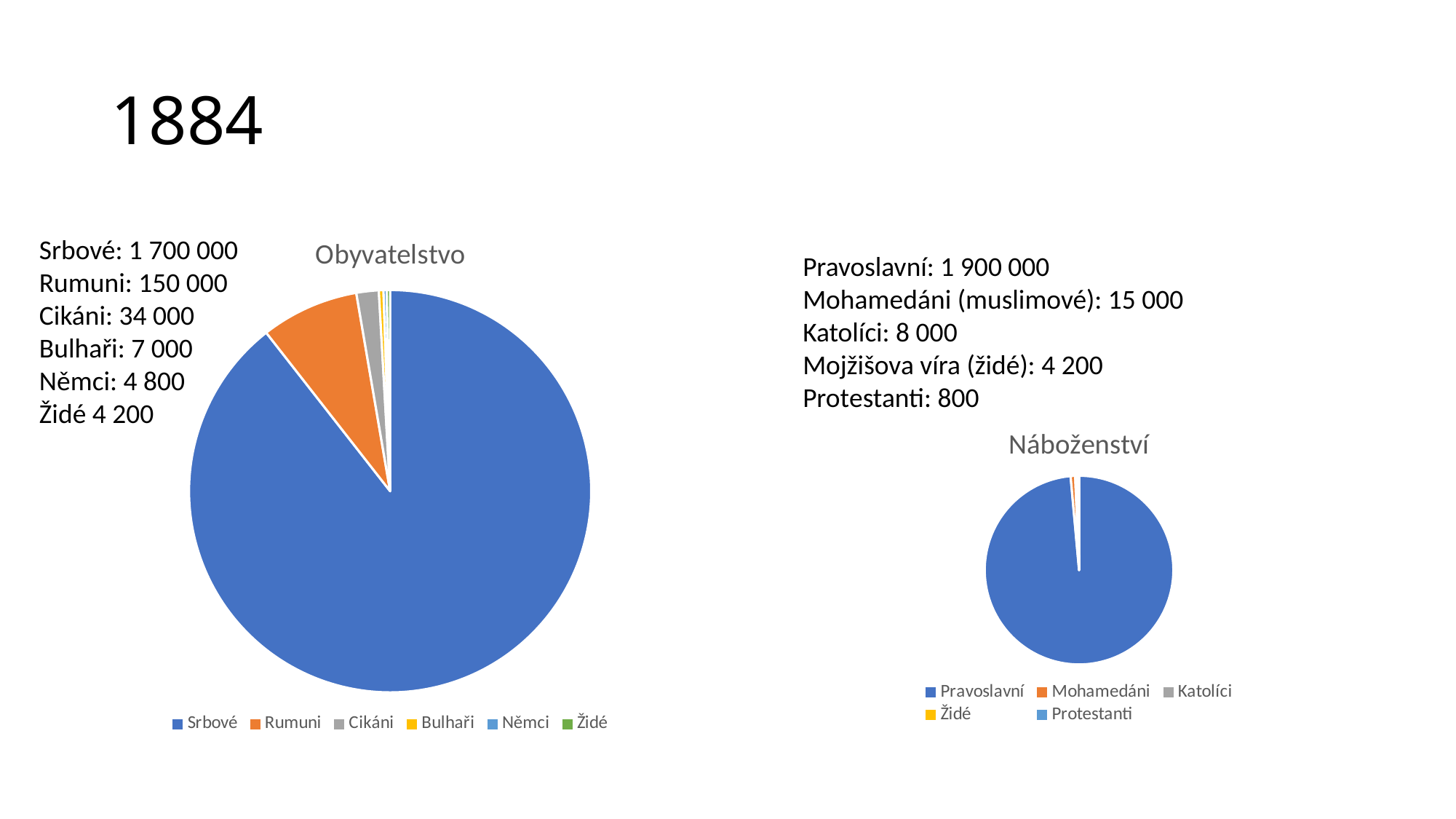
In the Obyvatelstvo chart, what is the value for Rumuni? 150 000 In the Náboženství chart, what is the value for Katolíci? 8 000 What is the title of the pie chart on the left of the slide? Obyvatelstvo How many categories does the legend of the Obyvatelstvo chart list? 6 In the Obyvatelstvo chart, which is larger, Rumuni or Cikáni? Rumuni In the Obyvatelstvo chart, what is the difference between the values for Srbové and Rumuni? 1 550 000 In the Náboženství chart, which category has the smallest value? Protestanti What kind of chart is the Obyvatelstvo chart? pie chart In the Obyvatelstvo chart, which category has the largest slice? Srbové How many categories does the legend of the Náboženství chart list? 5 In the Obyvatelstvo chart, what colour is the Srbové slice? blue In the Náboženství chart, which category has the largest slice? Pravoslavní